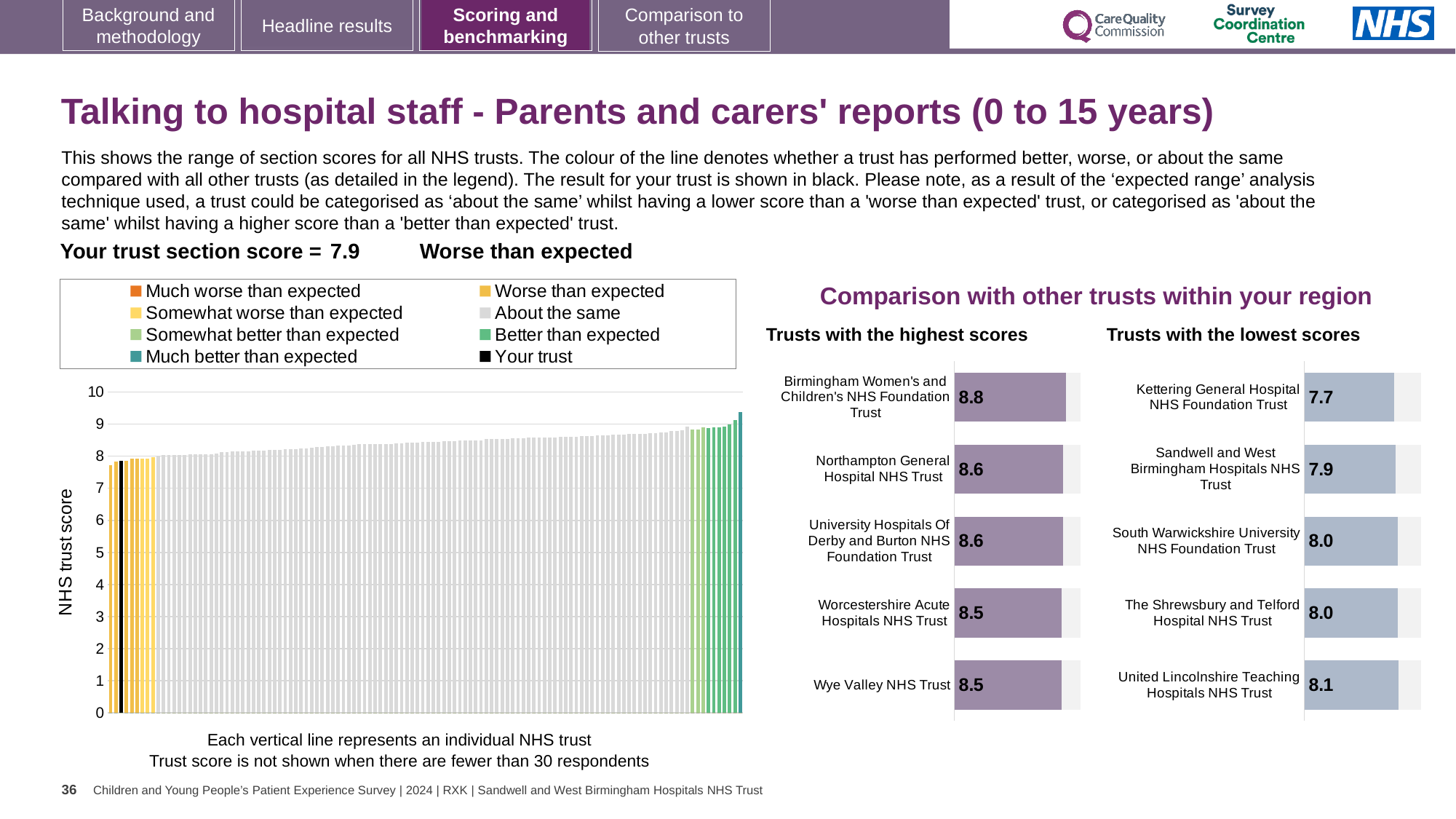
In the 'Trusts with the highest scores' chart, which has the higher score: Northampton General Hospital NHS Trust or Worcestershire Acute Hospitals NHS Trust? Northampton General Hospital NHS Trust In the 'Trusts with the highest scores' chart, what is the difference between the scores of Birmingham Women's and Children's NHS Foundation Trust and Wye Valley NHS Trust? 0.3 What kind of chart is the large chart on the left showing NHS trust scores? Bar chart In the 'Trusts with the lowest scores' chart, what is the score for Kettering General Hospital NHS Foundation Trust? 7.7 In the 'Trusts with the lowest scores' chart, what is the difference between the scores of United Lincolnshire Teaching Hospitals NHS Trust and Kettering General Hospital NHS Foundation Trust? 0.4 In the 'Trusts with the highest scores' chart, which trust has the highest score? Birmingham Women's and Children's NHS Foundation Trust In the 'Trusts with the highest scores' chart, what is the score for Birmingham Women's and Children's NHS Foundation Trust? 8.8 How many entries does the legend of the left-hand chart list? 8 According to the slide, what is your trust's section score shown in the left-hand chart? 7.9 In the left-hand chart of NHS trust scores, do the values rise or fall from left to right? Rise In the 'Trusts with the lowest scores' chart, which trust has the lowest score? Kettering General Hospital NHS Foundation Trust How many trusts are shown in the 'Trusts with the highest scores' chart? 5